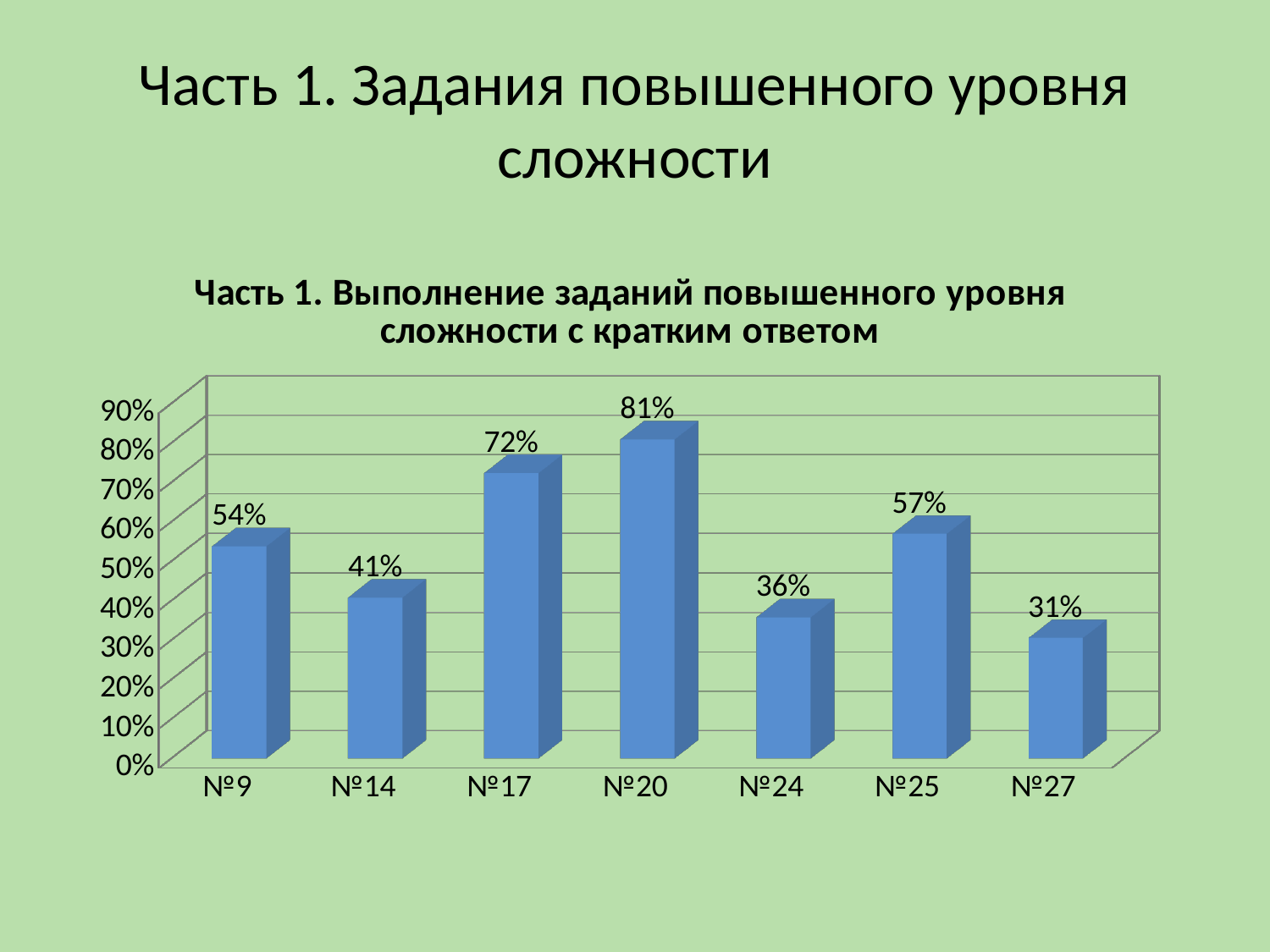
Which category has the highest value? №20 What is the value for №25? 57% Which is larger, the value for №9 or the value for №25? №25 What is the difference between the values for №20 and №27? 50% What kind of chart is shown on the slide? bar chart Is the value for №14 greater or less than 50%? less How many categories are shown on the x axis? 7 Which category has the lowest value? №27 What is the value for №9? 54% What is the difference between the values for №17 and №14? 31% What is the title of the chart? Часть 1. Выполнение заданий повышенного уровня сложности с кратким ответом What is the value for №24? 36%